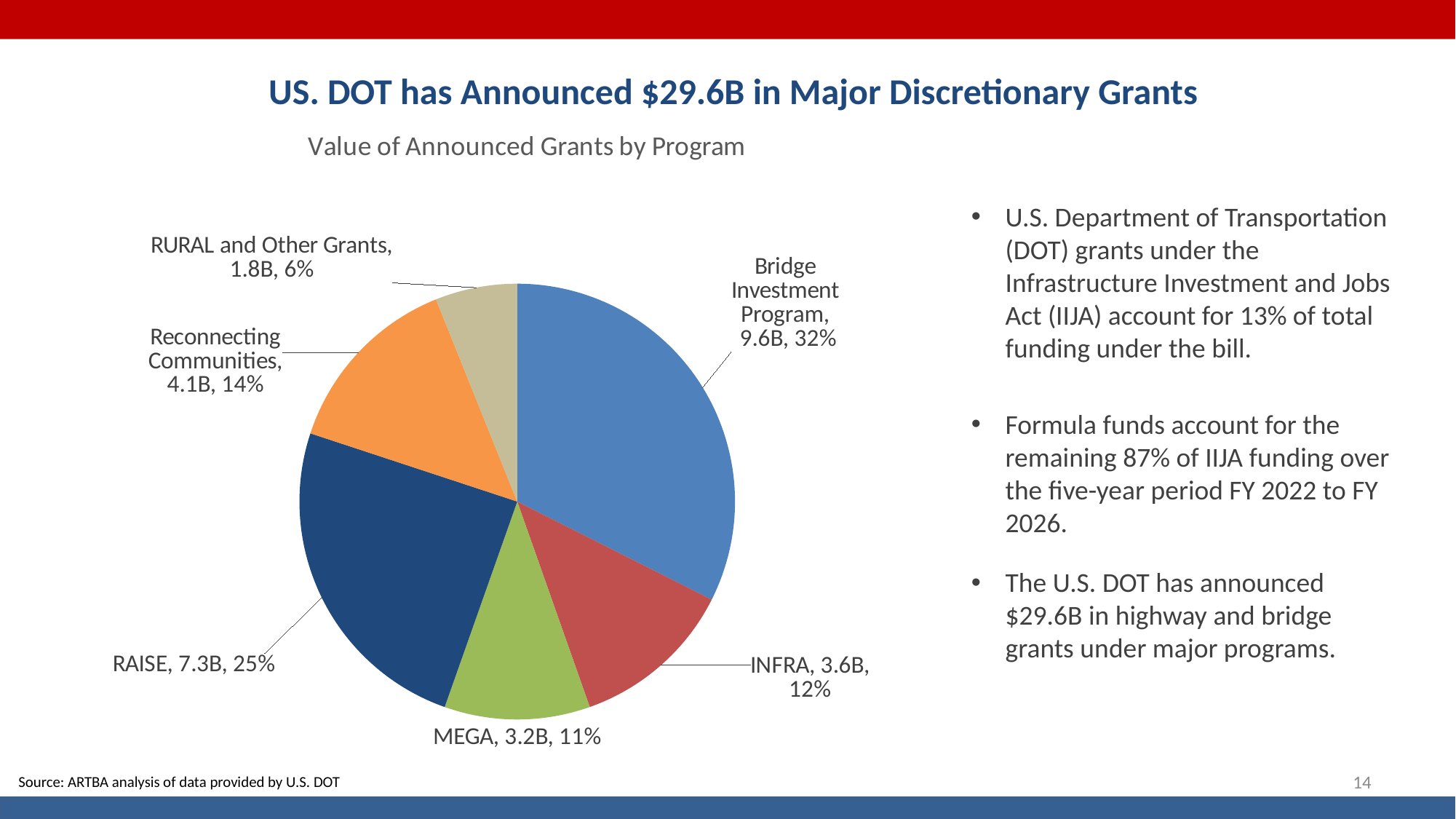
Which program has the largest share of announced grants? Bridge Investment Program What is the difference in value between RAISE and MEGA grants? 4.1B What is the title of the chart? Value of Announced Grants by Program What is the value of announced grants for the Bridge Investment Program? 9.6B How many slices does the pie chart have? 6 What is the value of announced grants for Reconnecting Communities? 4.1B What type of chart is shown on the slide? Pie chart What percentage share does INFRA have? 12% Which is larger, the value for INFRA or the value for MEGA? INFRA Which program has the smallest share of announced grants? RURAL and Other Grants What share of the pie does RAISE account for? 25% What colour is the RAISE slice? Dark blue